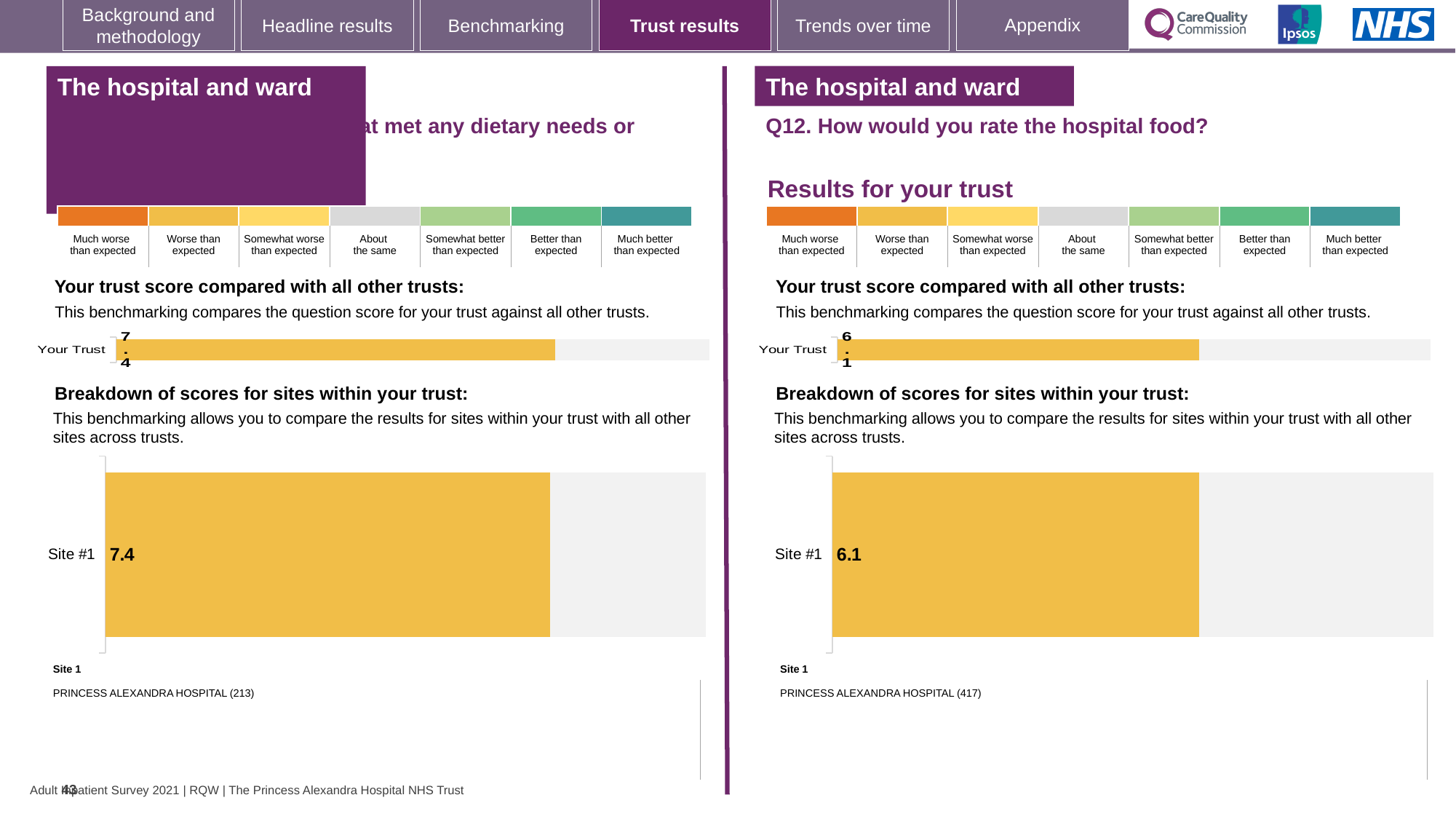
What is the difference between the Site #1 score on the left-hand chart (7.4) and the Site #1 score on the right-hand chart (6.1)? 1.3 How many sites are shown in the breakdown of scores on the left-hand chart? 1 On the left-hand chart, which site name is listed as Site 1? PRINCESS ALEXANDRA HOSPITAL (213) How many sites are shown in the breakdown of scores on the right-hand chart (Q12)? 1 On the right-hand chart (Q12. How would you rate the hospital food?), what is the score shown for Site #1? 6.1 On the right-hand chart (Q12), is the Your Trust score greater or less than the Your Trust score on the left-hand chart? less What kind of chart is used to show the breakdown of scores for sites within your trust on the right-hand side? Bar chart On the right-hand chart (Q12. How would you rate the hospital food?), what is the score shown for Your Trust? 6.1 On the right-hand chart (Q12), which site name is listed as Site 1? PRINCESS ALEXANDRA HOSPITAL (417) Which is larger: the Site #1 score on the left-hand chart or the Site #1 score on the right-hand chart (Q12)? Left-hand chart (7.4) On the left-hand chart, what is the score shown for Site #1? 7.4 On the left-hand chart, what is the score shown for Your Trust? 7.4